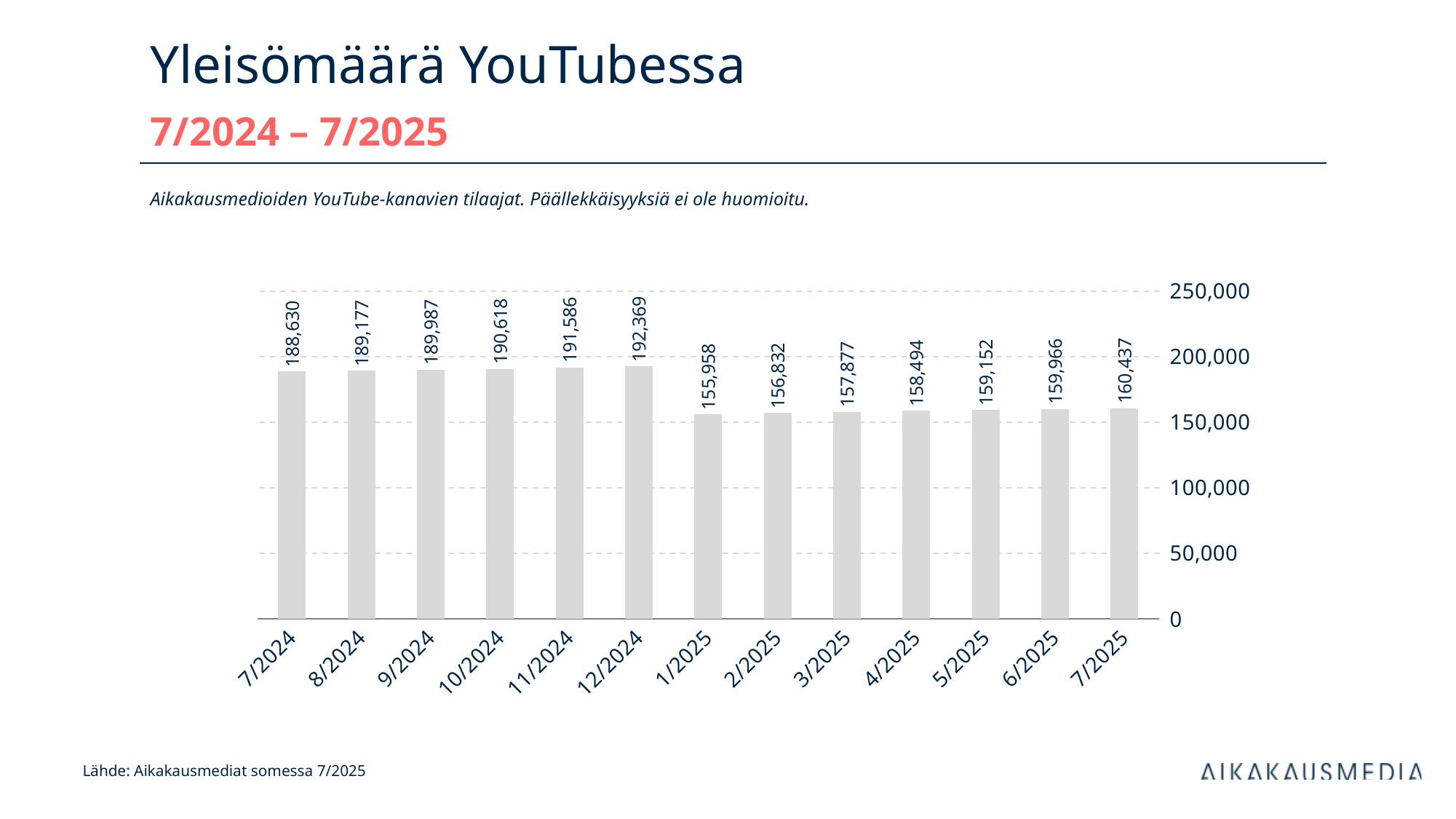
What is the difference between the values for 12/2024 and 1/2025? 36,411 Is the value for 3/2025 greater or less than 200,000? less What is the value for 7/2024? 188,630 Which is larger, the value for 12/2024 or the value for 1/2025? 12/2024 How many months are shown on the x axis? 13 What is the value for 7/2025? 160,437 What is the difference between the values for 7/2024 and 7/2025? 28,193 Which month has the lowest value? 1/2025 Which month has the highest value? 12/2024 What is the title of the chart on the slide? Yleisömäärä YouTubessa What kind of chart is shown on the slide? bar chart What is the value for 1/2025? 155,958